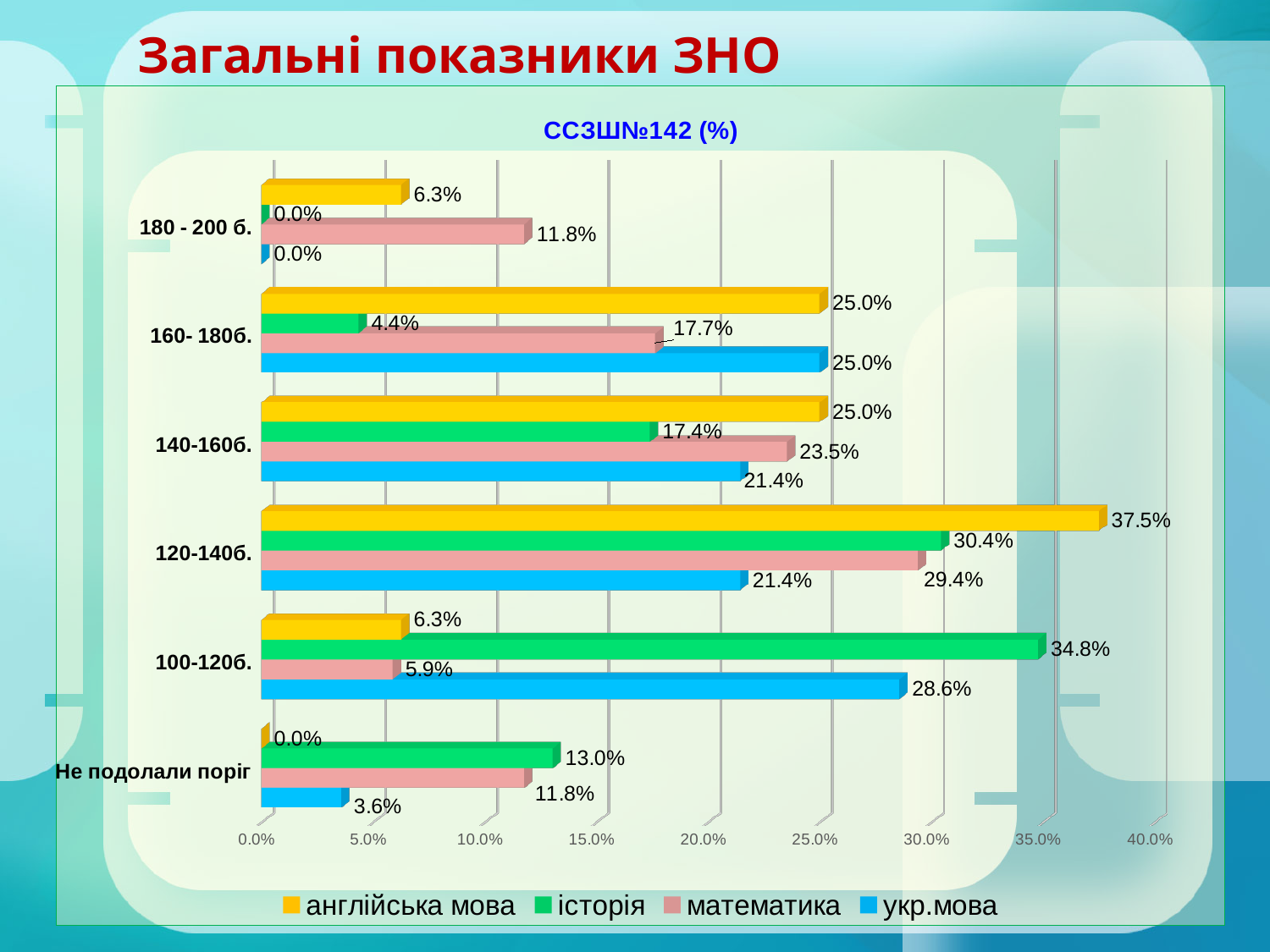
What is the value for історія in the 100-120б. category? 34.8% Which series has the lowest value in the 160- 180б. category? історія How many score categories are shown on the chart? 6 What is the title of the chart? ССЗШ№142 (%) What type of chart is shown on the slide? bar chart How many series does the legend list? 4 What is the value for англійська мова in the 120-140б. category? 37.5% What is the difference between історія and математика in the 100-120б. category? 28.9% What is the value for укр.мова in the Не подолали поріг category? 3.6% In which category does англійська мова have its highest value? 120-140б. What is the value for математика in the 140-160б. category? 23.5% Which is larger in the 140-160б. category: історія or укр.мова? укр.мова